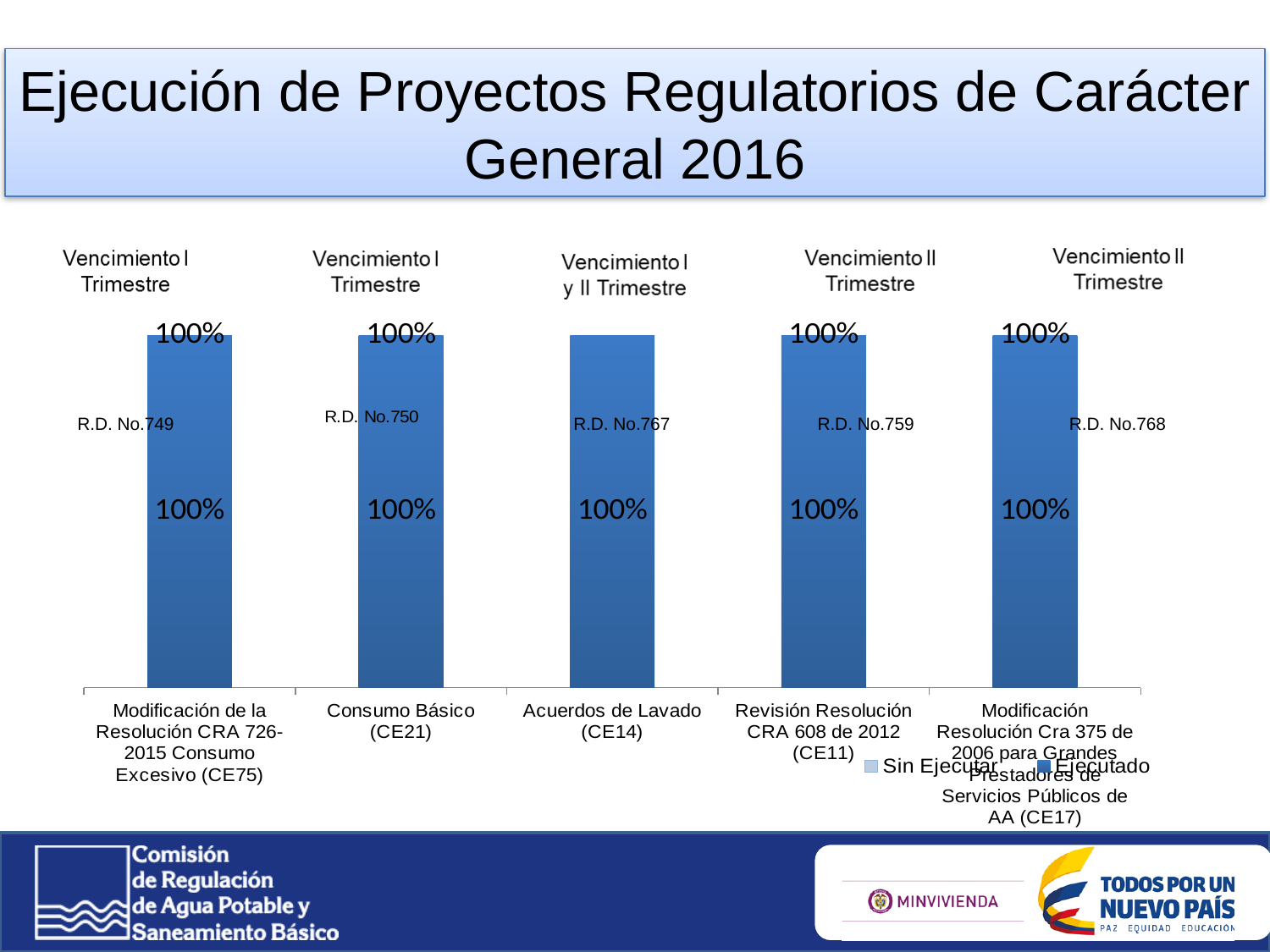
How many categories are plotted on the chart? 5 What are the two series named in the legend? Sin Ejecutar, Ejecutado Which R.D. number is shown above the bar for Acuerdos de Lavado (CE14)? R.D. No.767 What is the difference between the Ejecutado values for Consumo Básico (CE21) and Acuerdos de Lavado (CE14)? 0% What is the Ejecutado value for Consumo Básico (CE21)? 100% How many series does the legend list? 2 What is the title of the slide? Ejecución de Proyectos Regulatorios de Carácter General 2016 What is the Ejecutado value for Revisión Resolución CRA 608 de 2012 (CE11)? 100% What kind of chart is shown on the slide? bar chart What is the Ejecutado value for Acuerdos de Lavado (CE14)? 100% Do the Ejecutado values rise, fall, or stay the same across the categories from left to right? stay the same What is the Ejecutado value for Modificación de la Resolución CRA 726-2015 Consumo Excesivo (CE75)? 100%